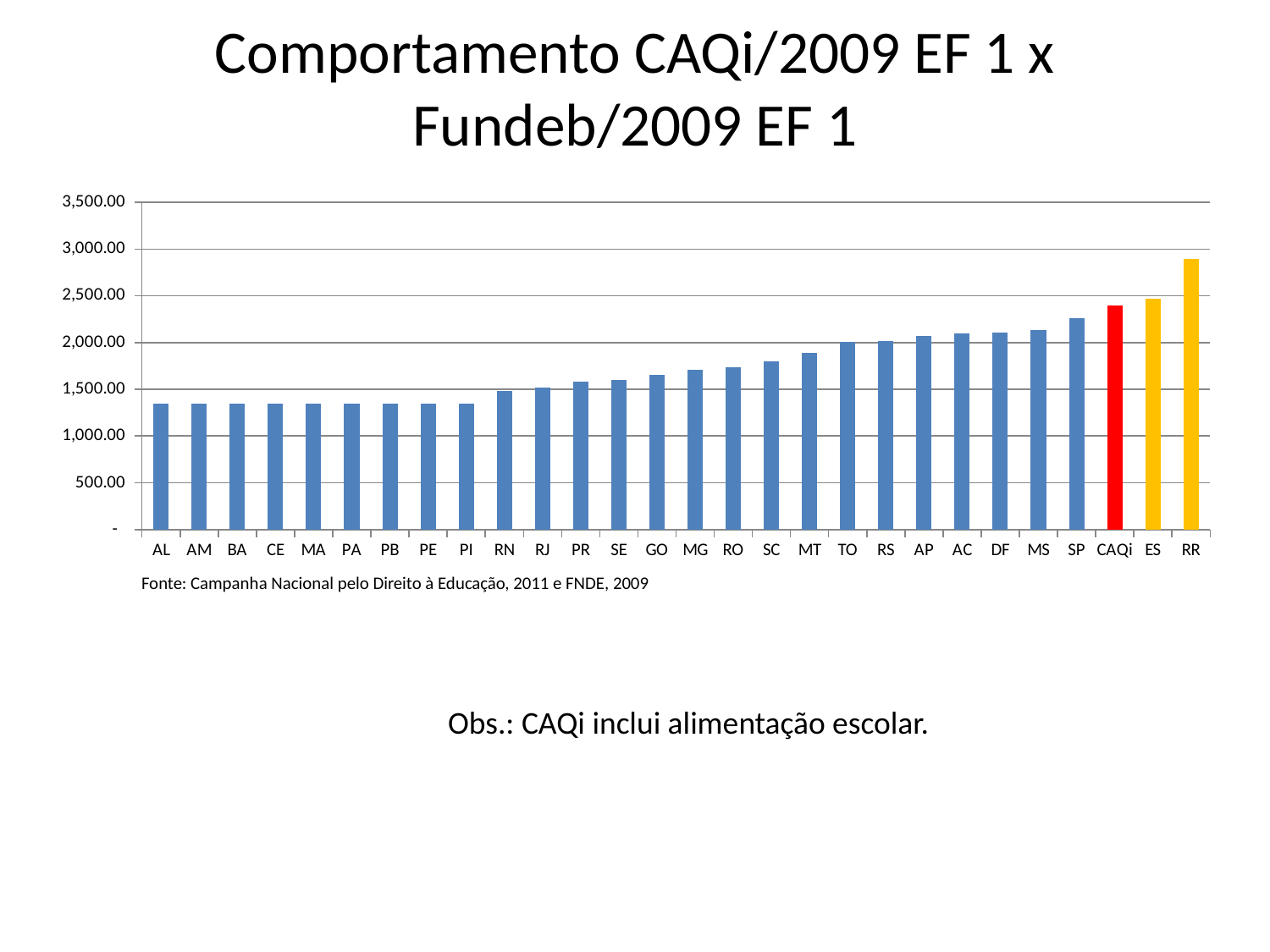
Is the value for SP greater or less than 2,500.00? less Is the value for ES greater or less than 2,000.00? greater Is the value for AL greater or less than 1,500.00? less Which is larger, the value for RR or the value for CAQi? RR What colour is the bar for CAQi? red What kind of chart is shown on the slide? bar chart Do the values generally rise or fall from left to right along the x axis? rise How many categories are plotted along the x axis? 28 Which category has the highest value? RR